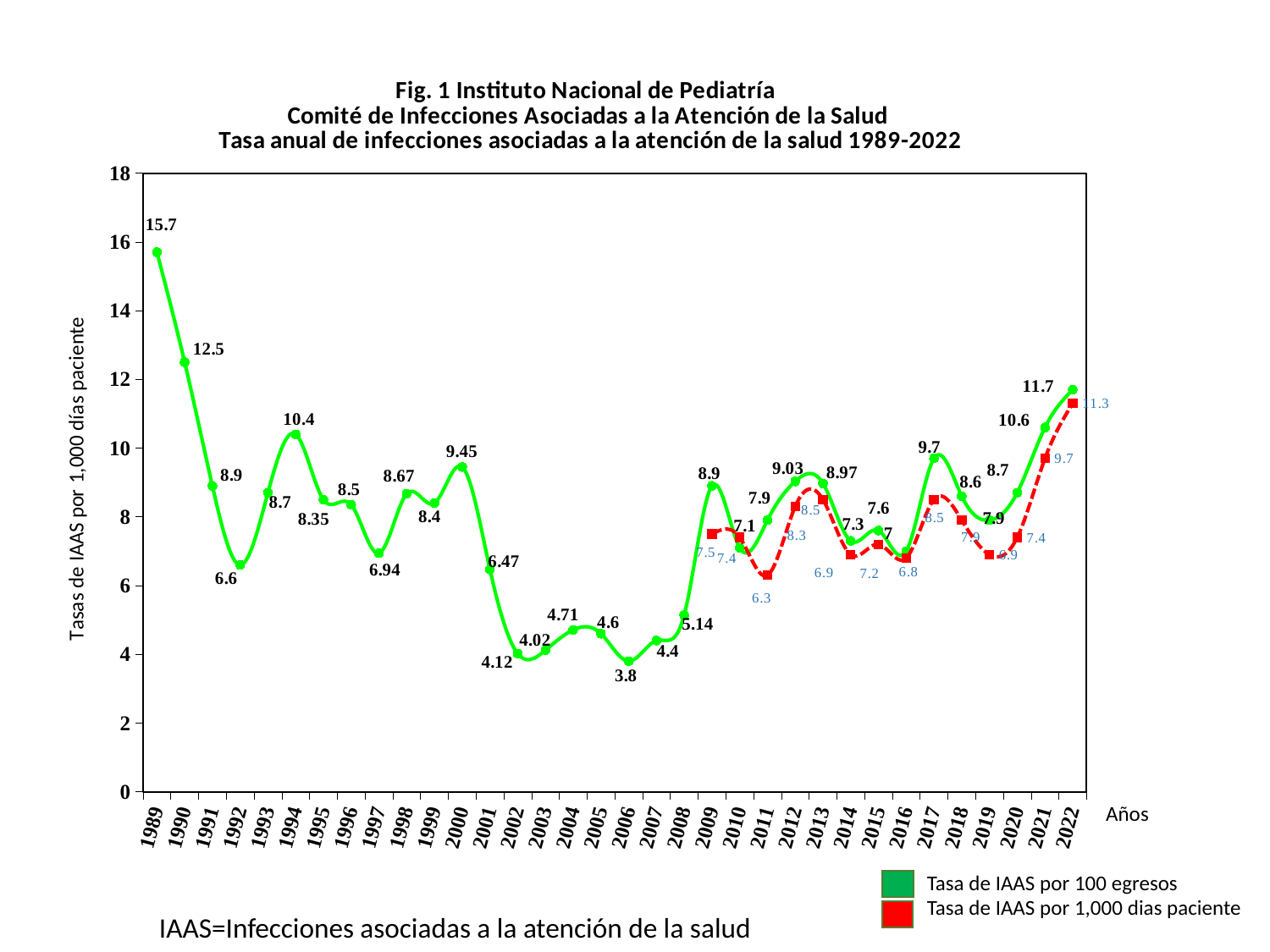
What kind of chart is shown on the slide? Line chart What is the difference between the Tasa de IAAS por 100 egresos values for 1989 and 1990? 3.2 What is the Tasa de IAAS por 100 egresos value for 2022? 11.7 What is the Tasa de IAAS por 1,000 días paciente value for 2022? 11.3 How many series does the legend list? 2 In which year is the Tasa de IAAS por 100 egresos highest? 1989 In which year is the Tasa de IAAS por 100 egresos lowest? 2006 In 2022, which series has the larger value: Tasa de IAAS por 100 egresos or Tasa de IAAS por 1,000 días paciente? Tasa de IAAS por 100 egresos What is the Tasa de IAAS por 100 egresos value for 1994? 10.4 How many years are shown on the x axis? 34 What is the Tasa de IAAS por 100 egresos value for 1989? 15.7 In which year is the Tasa de IAAS por 1,000 días paciente lowest? 2011